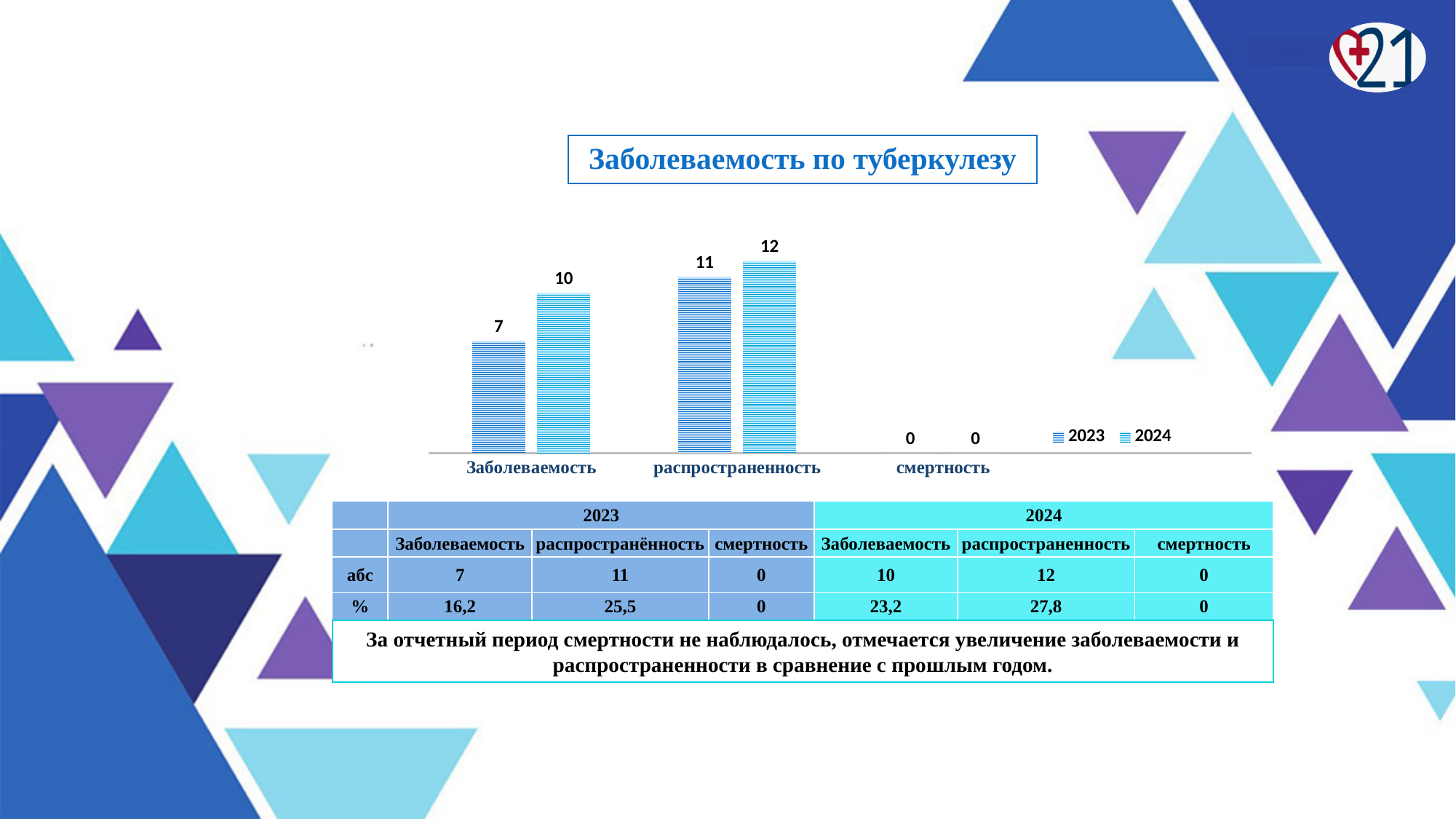
Which category has the highest value for the 2024 series? распространенность What is the value for Заболеваемость in 2023? 7 What kind of chart is shown on the slide? bar chart How many categories are shown on the x axis of the chart? 3 Which is larger: the 2023 value for распространенность or the 2024 value for Заболеваемость? 2023 value for распространенность What is the value for распространенность in 2024? 12 What is the value for Заболеваемость in 2024? 10 What is the value for распространенность in 2023? 11 Which category has the lowest value for the 2023 series? смертность How many series does the legend list? 2 What is the difference between the 2024 and 2023 values for Заболеваемость? 3 What is the value for смертность in 2024? 0